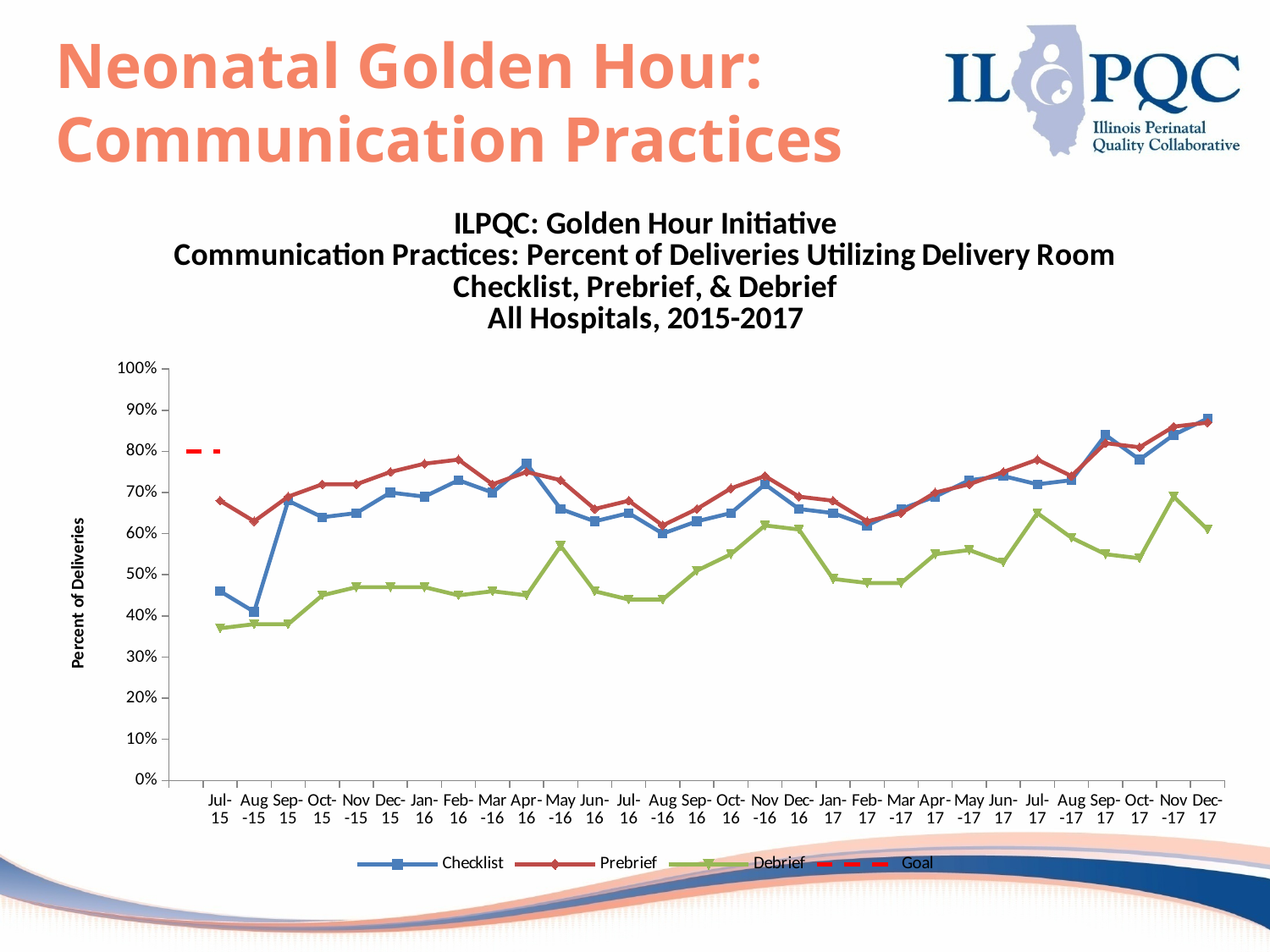
Is the Debrief value for Jul-15 greater or less than 40%? less How many series does the legend list? 4 Is the Prebrief value for Jul-15 greater or less than 60%? greater At what percentage is the Goal line drawn? 80% How many months are plotted along the x axis? 30 Is the Checklist value for Dec-17 greater or less than 80%? greater In Dec-17, which is larger, the Checklist value or the Debrief value? Checklist What kind of chart is shown on the slide? line chart Overall, does the Debrief series rise or fall from Jul-15 to Dec-17? rise In which month does the Debrief series reach its highest value? Nov-17 Which series has the lowest values across the whole period? Debrief